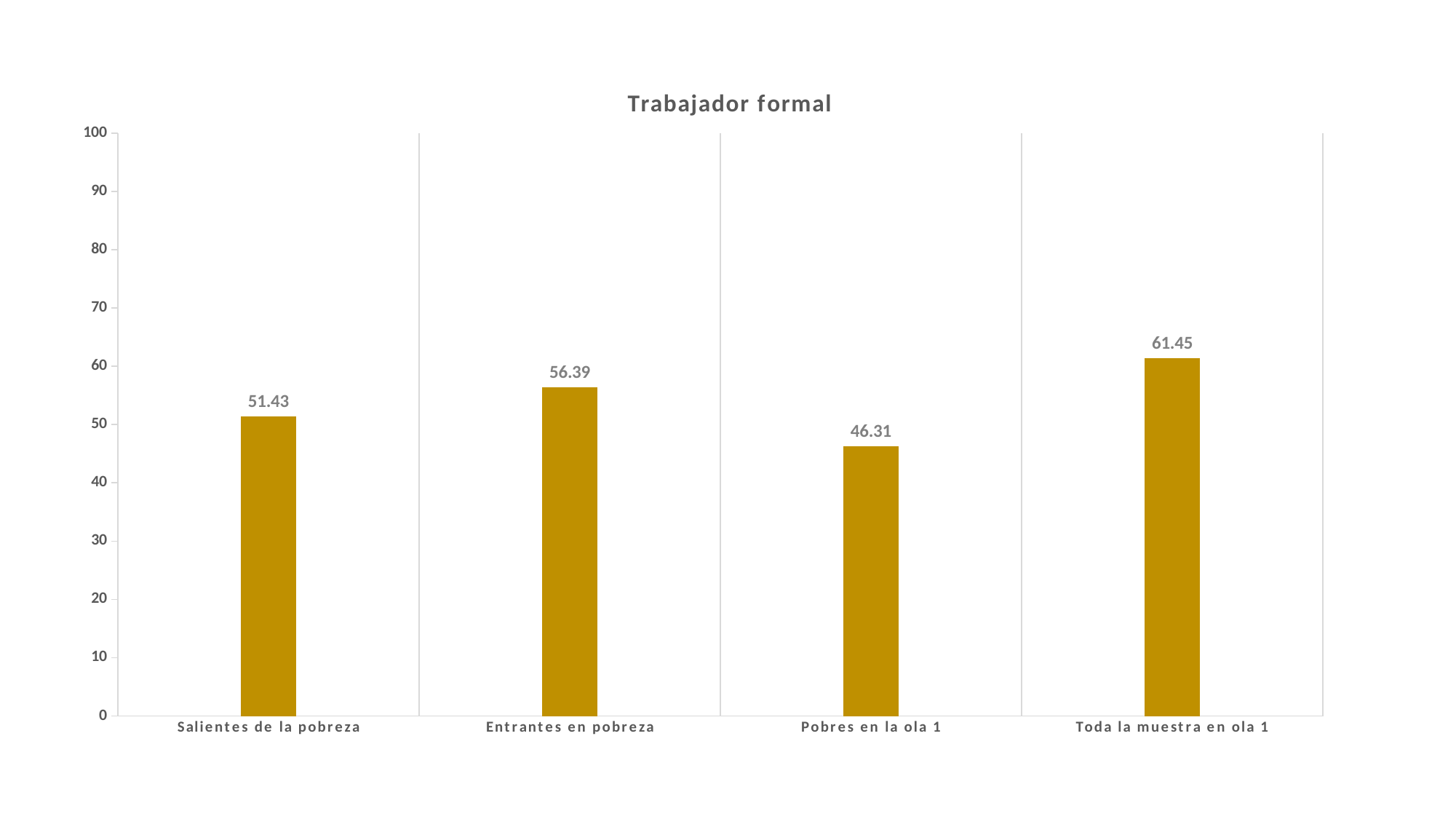
What is the title of the chart? Trabajador formal What is the difference between the values for Toda la muestra en ola 1 and Pobres en la ola 1? 15.14 Which category has the highest value? Toda la muestra en ola 1 What is the value for Entrantes en pobreza? 56.39 How many categories are shown on the chart? 4 What is the value for Salientes de la pobreza? 51.43 Which category has the lowest value? Pobres en la ola 1 Which is larger, the value for Entrantes en pobreza or the value for Salientes de la pobreza? Entrantes en pobreza What is the value for Pobres en la ola 1? 46.31 Is the value for Pobres en la ola 1 greater or less than 50? less What is the difference between the values for Entrantes en pobreza and Salientes de la pobreza? 4.96 What is the value for Toda la muestra en ola 1? 61.45